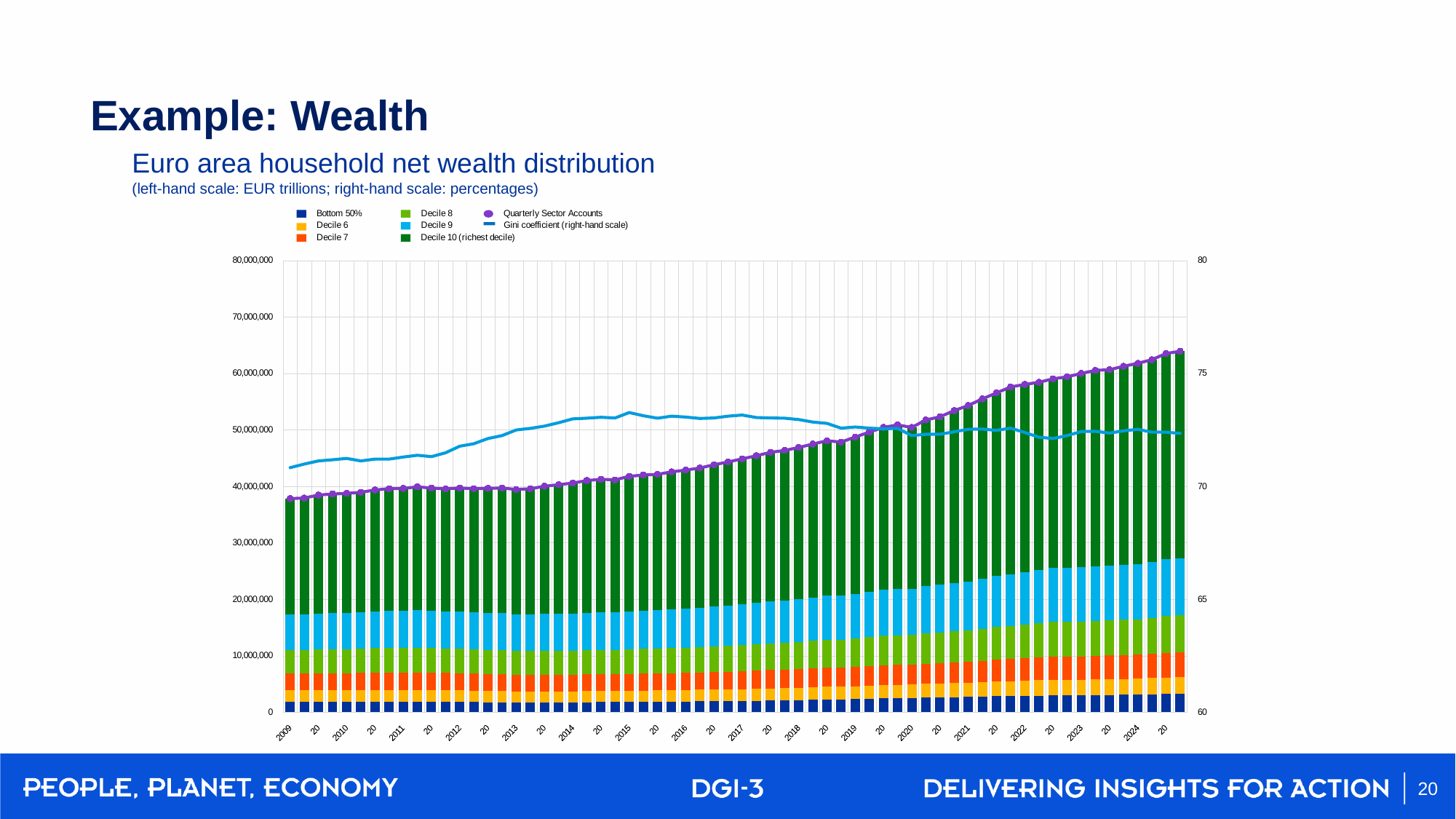
What units does the left-hand scale use according to the subtitle? EUR trillions Is the Gini coefficient in 2015 greater or less than 75? less Which legend entry is plotted on the right-hand scale? Gini coefficient How many series does the legend list? 8 Which year has the lowest total household net wealth? 2009 Which wealth group accounts for the largest segment of each bar? Decile 10 (richest decile) Is the total net wealth for the last bar in 2024 greater or less than 60,000,000? greater What kind of chart is used to show the Euro area household net wealth distribution? Stacked bar chart with line Is the total net wealth for the first bar in 2009 greater or less than 40,000,000? less Which year has the highest total household net wealth? 2024 Does total household net wealth rise or fall from 2009 to 2024? Rise